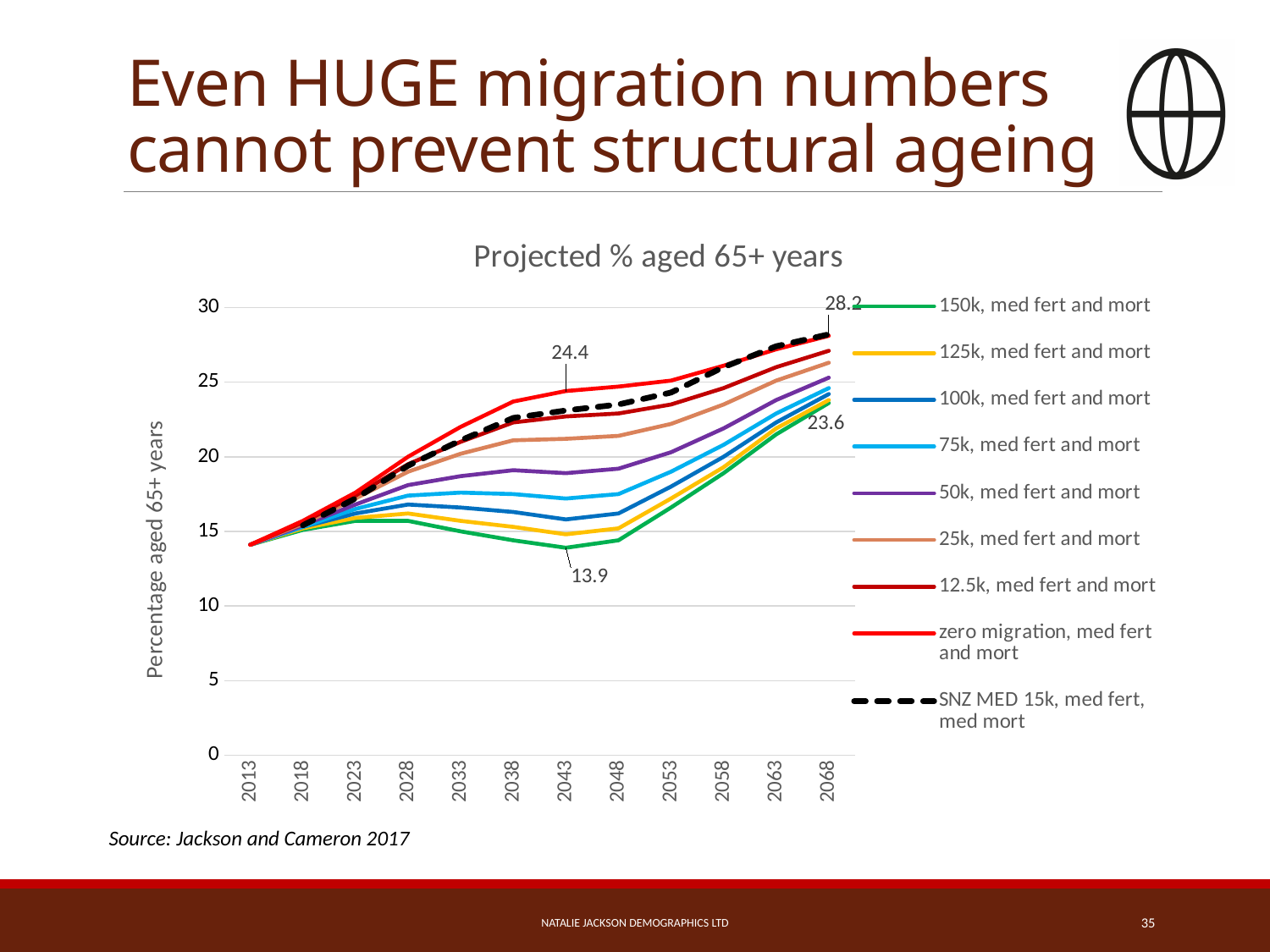
What is the title of the chart's vertical axis? Percentage aged 65+ years What is the projected % aged 65+ for the SNZ MED 15k, med fert, med mort series in 2068? 28.2 Is the value for the 150k, med fert and mort series in 2028 greater or less than 20? less Which series has the lowest value in 2043? 150k, med fert and mort What is the projected % aged 65+ for the zero migration, med fert and mort series in 2043? 24.4 What is the projected % aged 65+ for the 150k, med fert and mort series in 2043? 13.9 How many years are labelled along the x axis of the chart? 12 How many series does the legend of the chart list? 9 Does the zero migration, med fert and mort series rise or fall from 2013 to 2068? Rise In 2043, what is the difference between the zero migration series and the 150k series? 10.5 What kind of chart is shown on the slide? Line chart What is the projected % aged 65+ for the 150k, med fert and mort series in 2068? 23.6